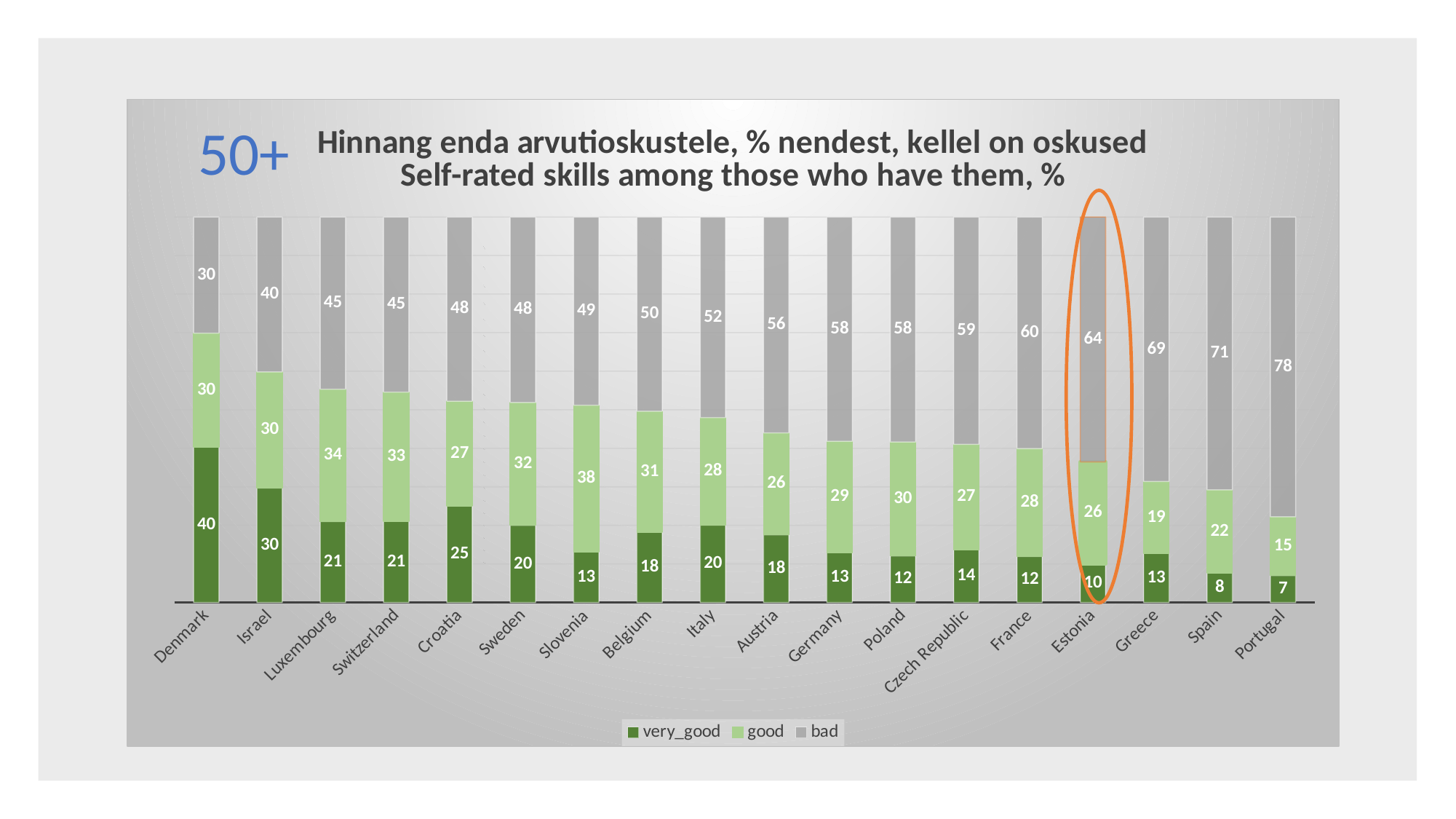
What kind of chart is shown on the slide? Stacked bar chart What is the value of the "bad" series for Estonia? 64 Which country's bar is highlighted with an orange oval? Estonia Which country has the highest "bad" value? Portugal Which has the larger "good" value, Slovenia or Belgium? Slovenia Which country has the lowest "very_good" value? Portugal What is the difference between the "bad" value for Portugal and the "bad" value for Denmark? 48 What is the "very_good" value for Denmark? 40 How many series does the legend list? 3 How many countries are shown on the x axis? 18 Which country has the highest "very_good" value? Denmark Does the "bad" series rise or fall moving from Denmark on the left to Portugal on the right? Rise